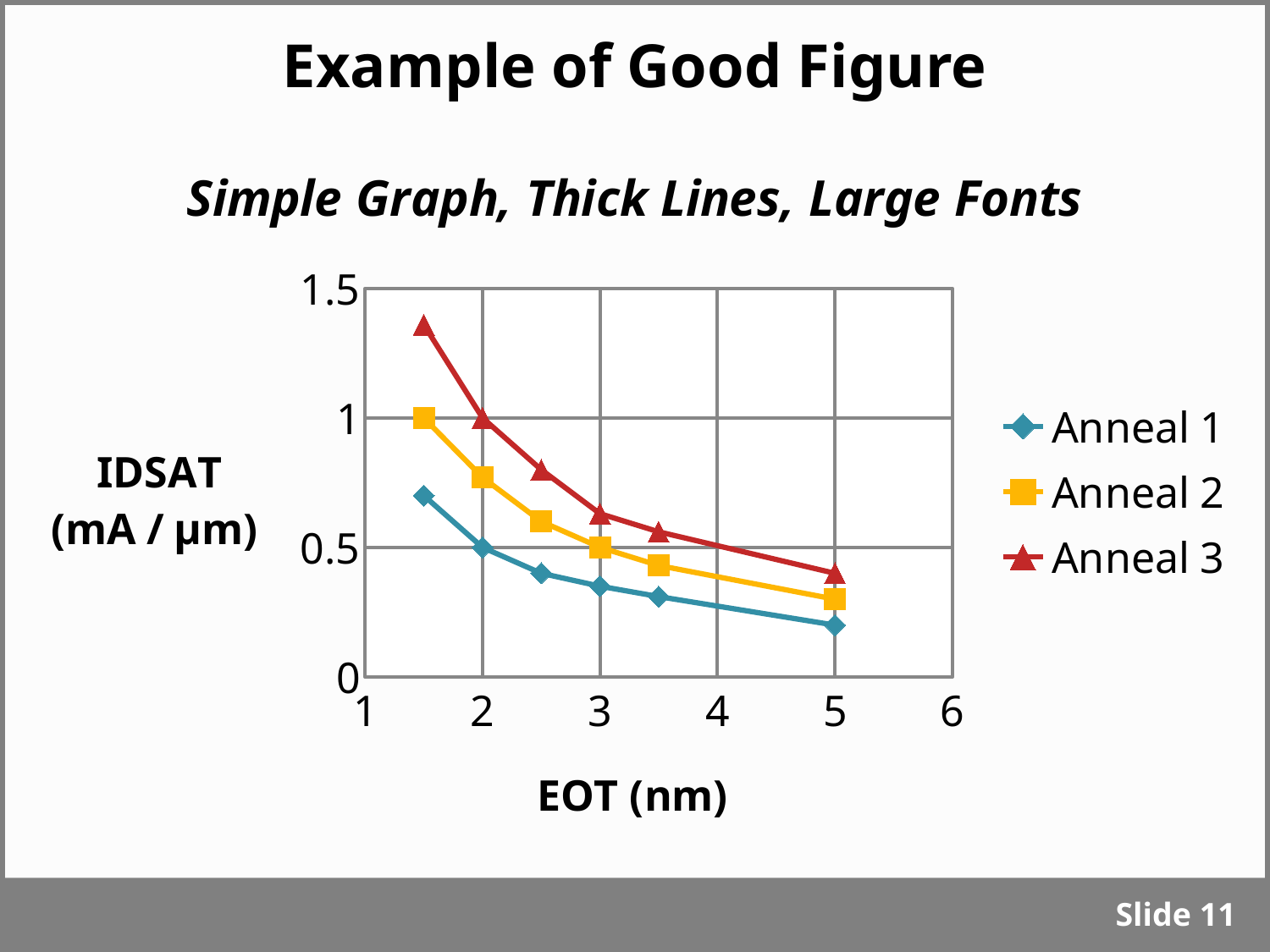
Is the IDSAT value for Anneal 3 at EOT = 1.5 nm greater or less than 1? greater Is the IDSAT value for Anneal 1 at EOT = 5 nm greater or less than 0.5? less What is the label of the x axis? EOT (nm) How many series does the legend list? 3 Which series has the highest IDSAT value at EOT = 1.5 nm? Anneal 3 Which series has the lowest IDSAT value at EOT = 5 nm? Anneal 1 What kind of chart is shown on the slide? line chart How many data points are plotted for the Anneal 1 series? 6 At EOT = 3 nm, which series has the larger IDSAT value, Anneal 1 or Anneal 2? Anneal 2 Do the IDSAT values rise or fall as EOT increases? fall What is the label of the y axis? IDSAT (mA / µm)